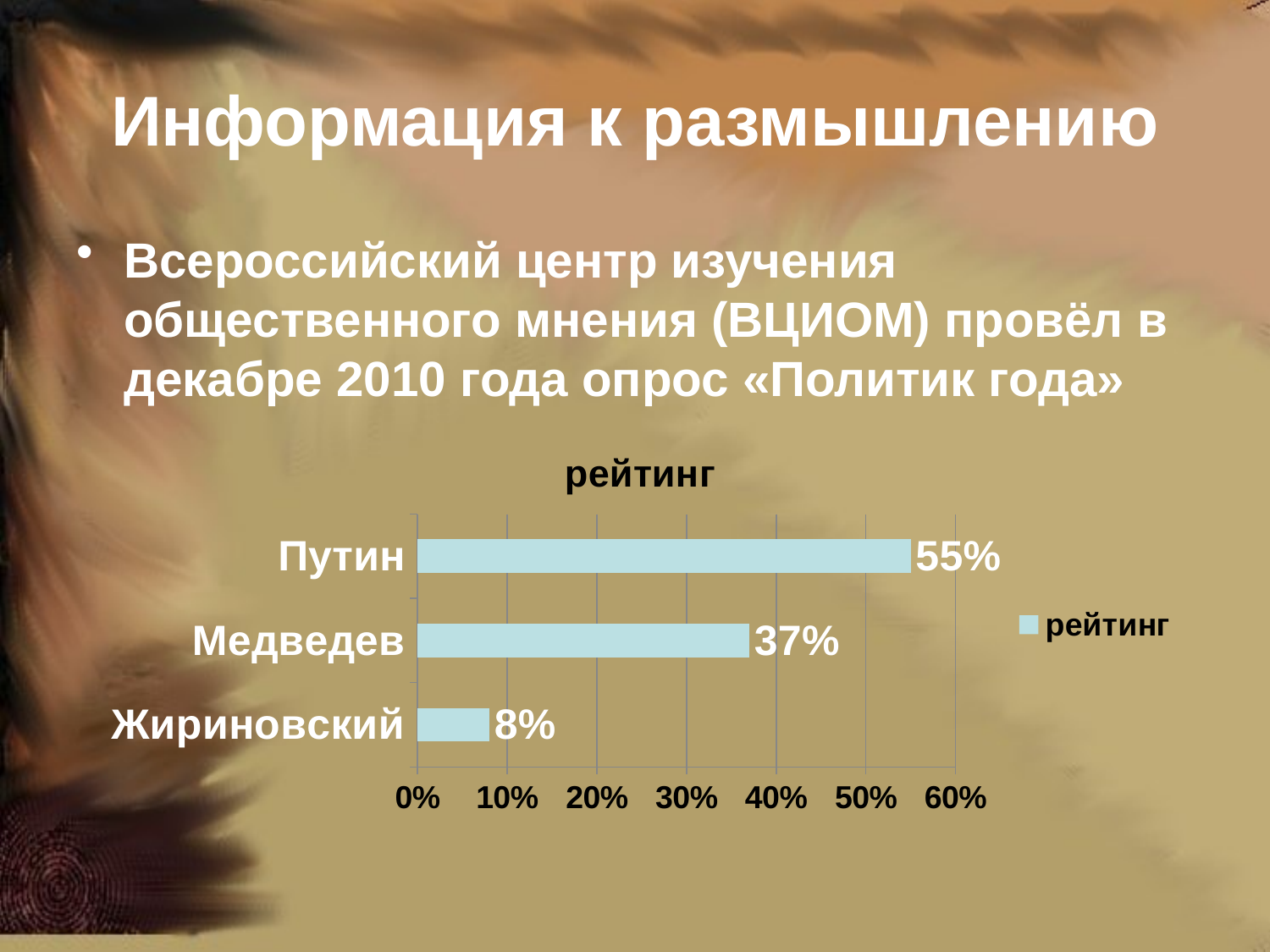
What is the rating value for Путин? 55% Is the value for Медведев greater or less than 40%? less What is the rating value for Жириновский? 8% Which politician has the highest rating in the chart? Путин What is the rating value for Медведев? 37% What is the difference between the ratings of Медведев and Жириновский? 29% What type of chart is shown on the slide? bar chart How many series does the legend list? 1 Which politician has the lowest rating in the chart? Жириновский Who has a higher rating, Медведев or Жириновский? Медведев How many politicians are shown in the chart? 3 What is the difference between the ratings of Путин and Медведев? 18%